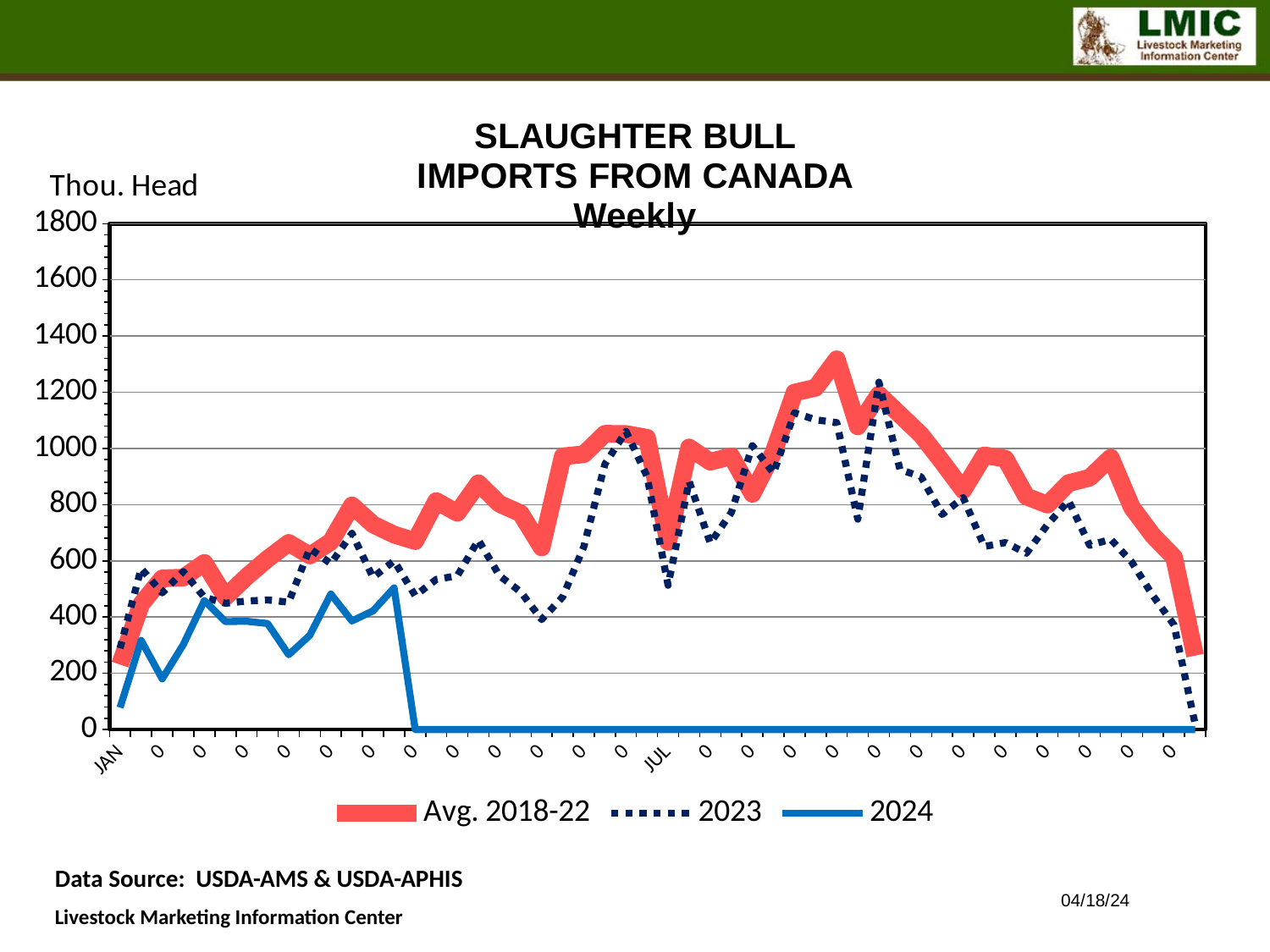
Is the peak value of the Avg. 2018-22 series greater or less than 1200? greater What are the three series listed in the legend? Avg. 2018-22, 2023, 2024 Is the highest value of the 2024 series greater or less than 400? greater How many series does the legend list? 3 Is the value of the 2024 series at JAN greater or less than 200? less Does the Avg. 2018-22 series generally rise or fall from JAN to JUL? rise What kind of chart is shown on the slide? line chart At JUL, which is larger: the Avg. 2018-22 series or the 2024 series? Avg. 2018-22 What unit label is shown above the vertical axis? Thou. Head Which series reaches the highest peak on the chart? Avg. 2018-22